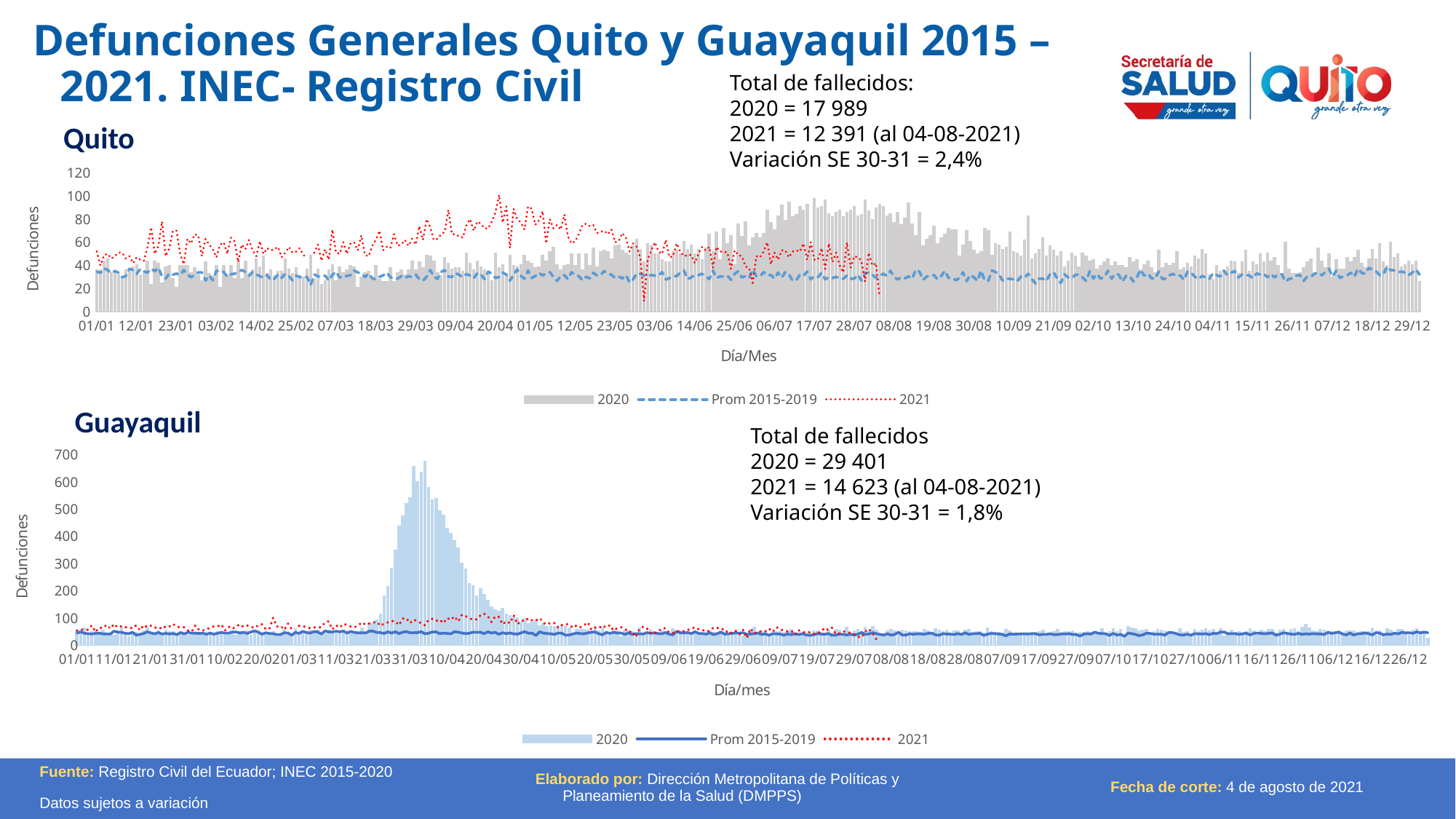
On the Guayaquil chart, what is the highest value shown on the y axis? 700 On the Quito chart, is the highest 2020 bar greater or less than 80? greater On the Guayaquil chart, what kind of chart is it? Combined bar and line chart On the Guayaquil chart, is the highest 2020 bar greater or less than 600? greater On the Quito chart, what is the highest value shown on the y axis? 120 On the Guayaquil chart, which series reaches the higher peak: 2020 or 2021? 2020 On the Quito chart, in January, which is higher: the 2021 line or the 2020 bars? 2021 line On the Quito chart, how many series does the legend list? 3 On the Guayaquil chart, is the 2021 dotted line in January greater or less than 100? less On the Guayaquil chart, between which two x-axis labels do the 2020 bars reach their peak? 31/03 and 10/04 On the Quito chart, does the 2021 line generally rise or fall from January to April? rise On the Quito chart, in which month do the 2020 bars reach their highest values? July